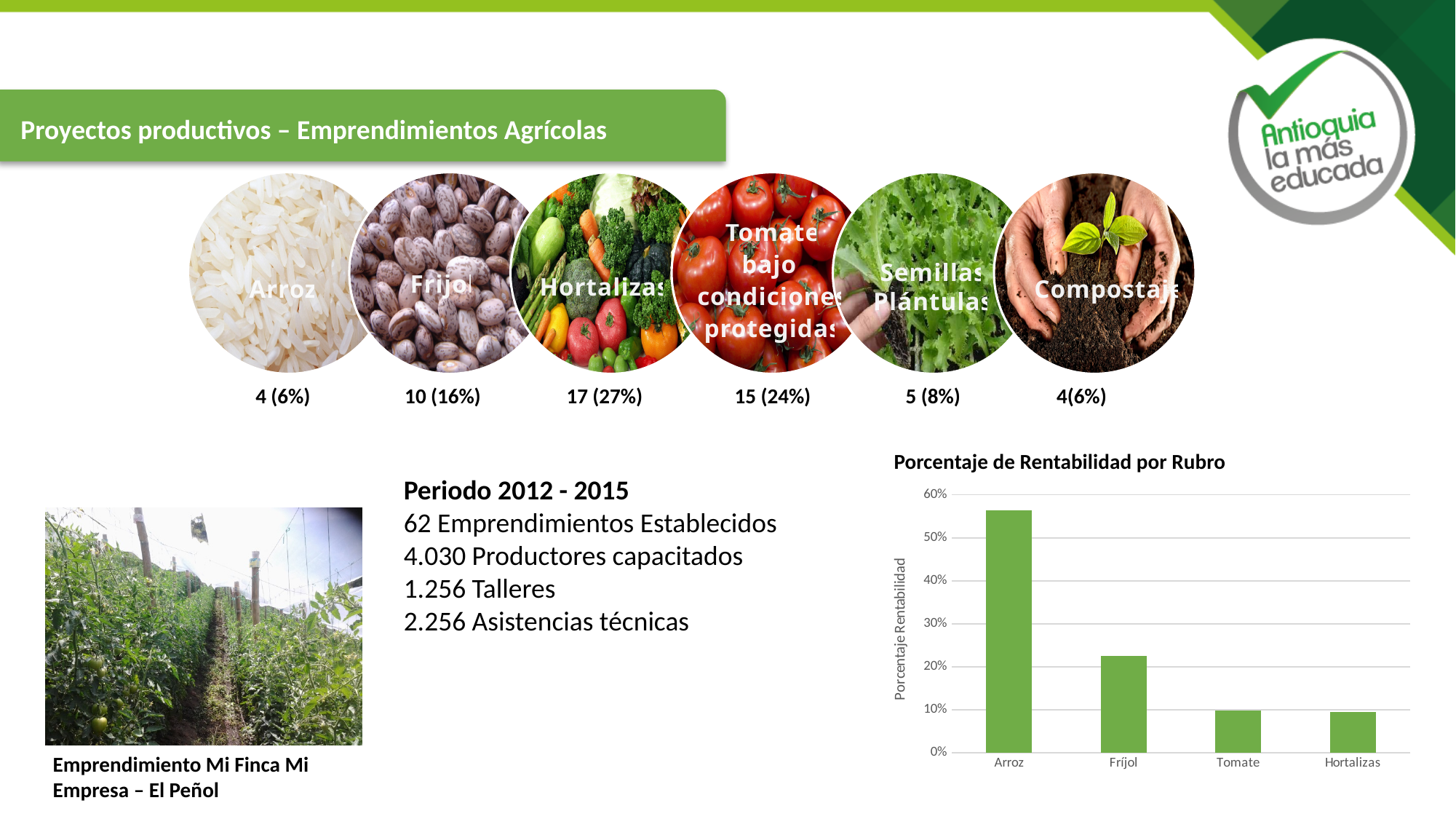
In the "Porcentaje de Rentabilidad por Rubro" chart, is the value for Arroz greater or less than 50%? greater What kind of chart is "Porcentaje de Rentabilidad por Rubro"? Bar chart In the "Porcentaje de Rentabilidad por Rubro" chart, is the value for Fríjol greater or less than 30%? less In the "Porcentaje de Rentabilidad por Rubro" chart, which is larger, Arroz or Fríjol? Arroz In the "Porcentaje de Rentabilidad por Rubro" chart, is the value for Fríjol greater or less than 20%? greater What is the label of the vertical axis in the "Porcentaje de Rentabilidad por Rubro" chart? Porcentaje Rentabilidad How many categories are shown on the x axis of the "Porcentaje de Rentabilidad por Rubro" chart? 4 In the "Porcentaje de Rentabilidad por Rubro" chart, do the values rise or fall from left to right along the x axis? Fall What is the title of the bar chart on the slide? Porcentaje de Rentabilidad por Rubro In the "Porcentaje de Rentabilidad por Rubro" chart, which is larger, Fríjol or Tomate? Fríjol In the "Porcentaje de Rentabilidad por Rubro" chart, which category has the highest value? Arroz